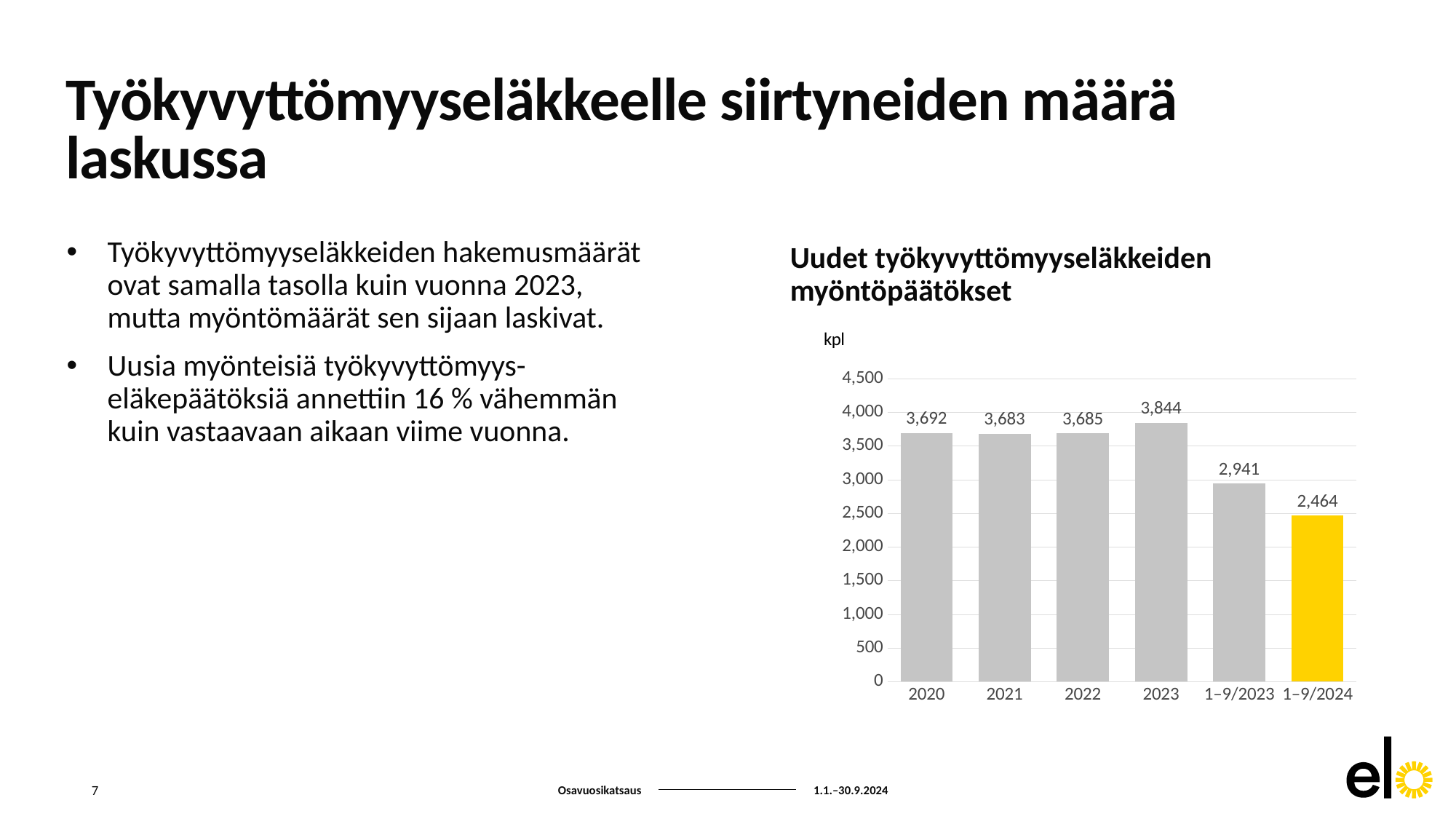
What is the value for 2020? 3,692 Which category has the lowest value? 1–9/2024 What kind of chart is shown on the slide? bar chart What is the difference between the values for 1–9/2023 and 1–9/2024? 477 Which bar is coloured yellow? 1–9/2024 Is the value for 1–9/2023 greater or less than 3,000? less How many categories are shown on the x axis? 6 What is the value for 1–9/2024? 2,464 What is the title of the chart? Uudet työkyvyttömyyseläkkeiden myöntöpäätökset Which is larger, the value for 2023 or the value for 2022? 2023 Which category has the highest value? 2023 What is the value for 2023? 3,844